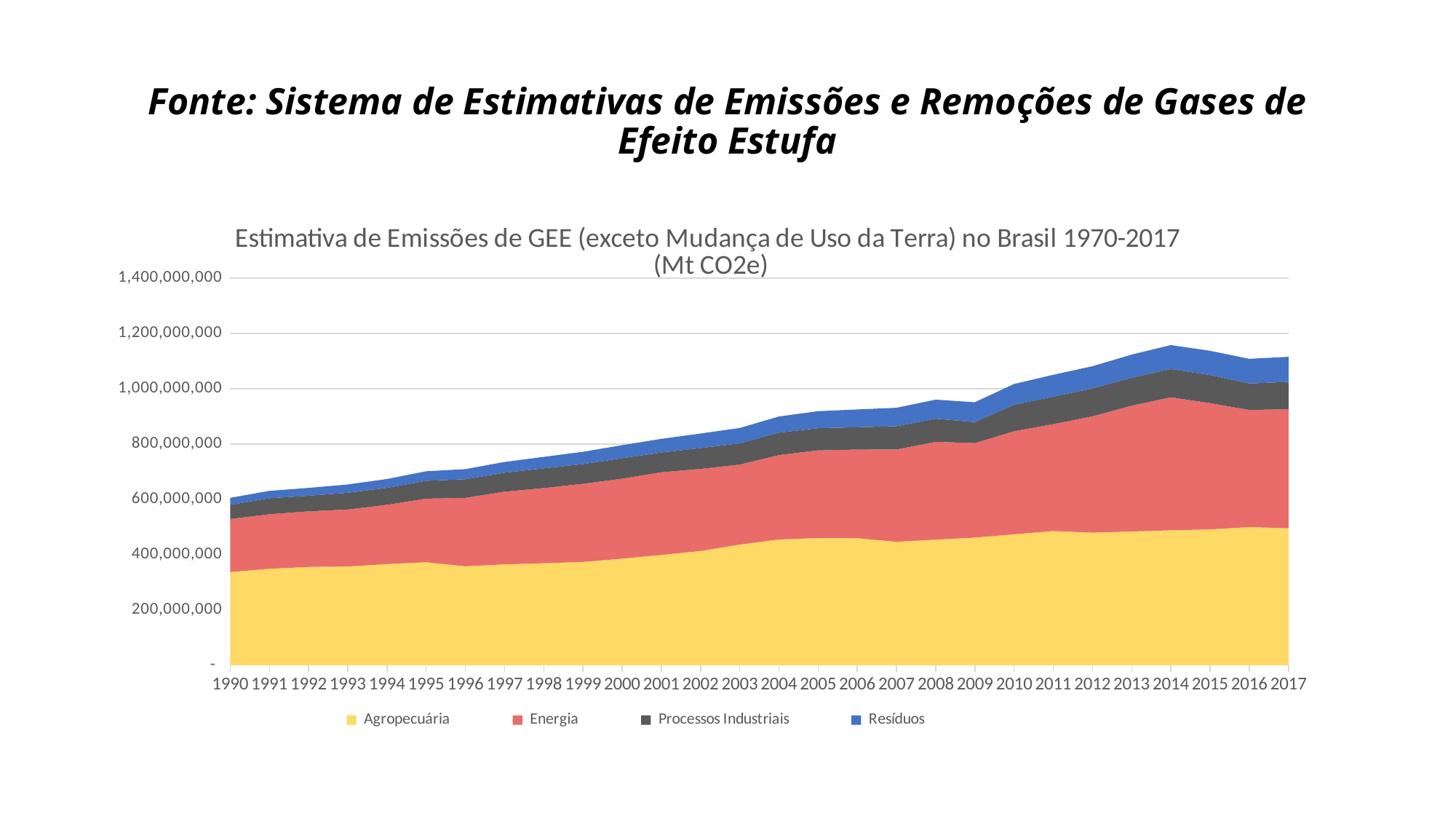
In 2017, which series contributes more: Agropecuária or Resíduos? Agropecuária How many years are plotted along the x axis? 28 Is the total stacked value for 2014 greater or less than 1,000,000,000? greater What is the title of the chart? Estimativa de Emissões de GEE (exceto Mudança de Uso da Terra) no Brasil 1970-2017 (Mt CO2e) In which year is the total stacked value lowest? 1990 Is the Agropecuária value for 1990 greater or less than 400,000,000? less In which year is the total stacked value highest? 2014 What kind of chart is shown on the slide? Stacked area chart Is the total stacked value for 1990 greater or less than 800,000,000? less How many series does the legend list? 4 Do total emissions generally rise or fall from 1990 to 2017? Rise Which series is shown in yellow? Agropecuária